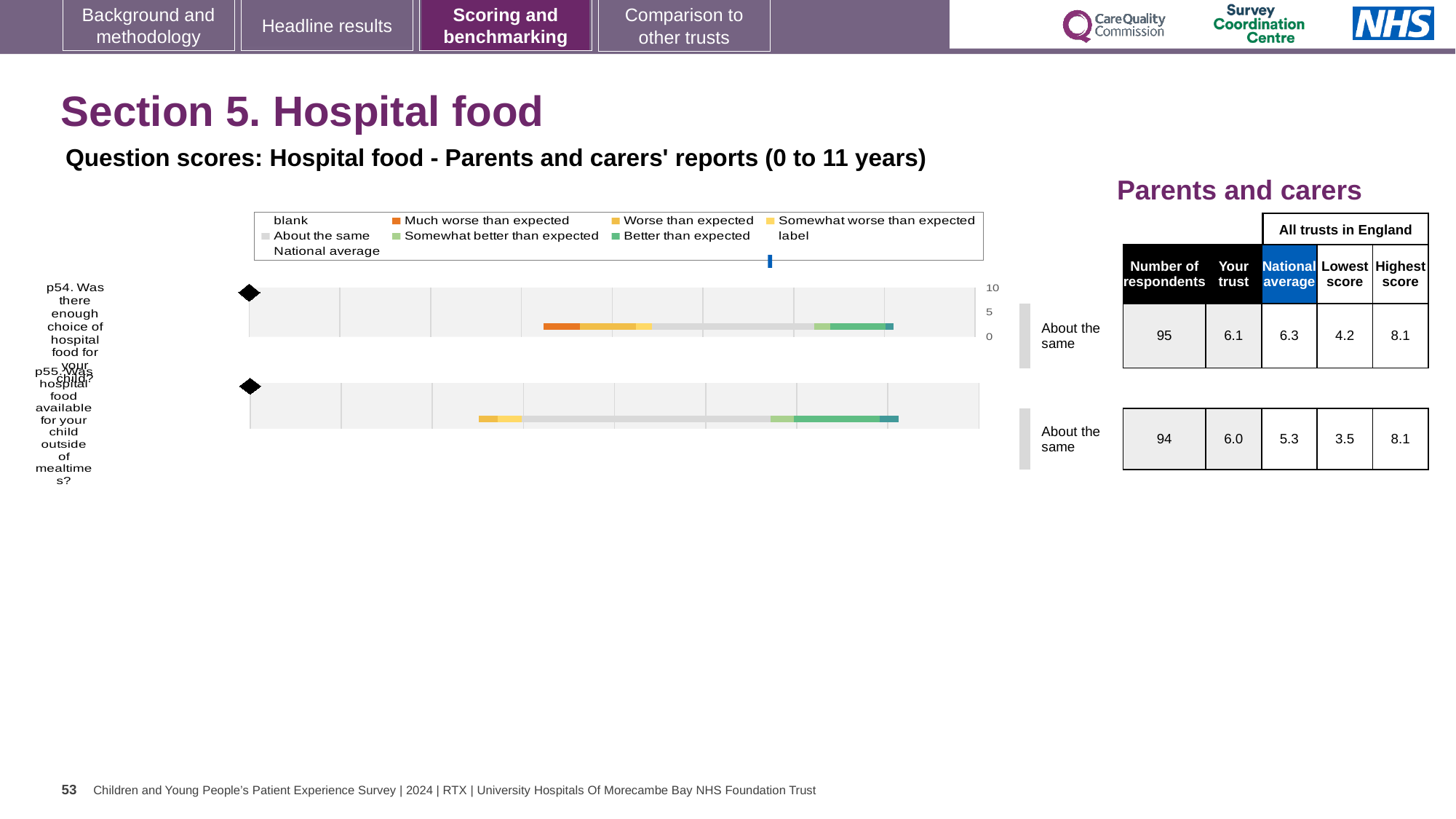
What is the highest score among all trusts in England for p54? 8.1 What is the national average score for p55 (hospital food available outside of mealtimes)? 5.3 How many respondents answered p54? 95 How many survey questions (bars) are plotted in the hospital food chart? 2 What benchmark category is p55 placed in? About the same What kind of chart is used to show the question scores for hospital food? bar chart What is the 'Your trust' score for p54 (enough choice of hospital food for your child)? 6.1 What is the difference between the highest score and the lowest score for p55? 4.6 Which question has the higher 'Your trust' score, p54 or p55? p54 In the chart legend, which colour represents 'Much worse than expected'? orange Which is larger for p55: the 'Your trust' score or the national average? Your trust In the chart legend, which category is shown in grey? About the same